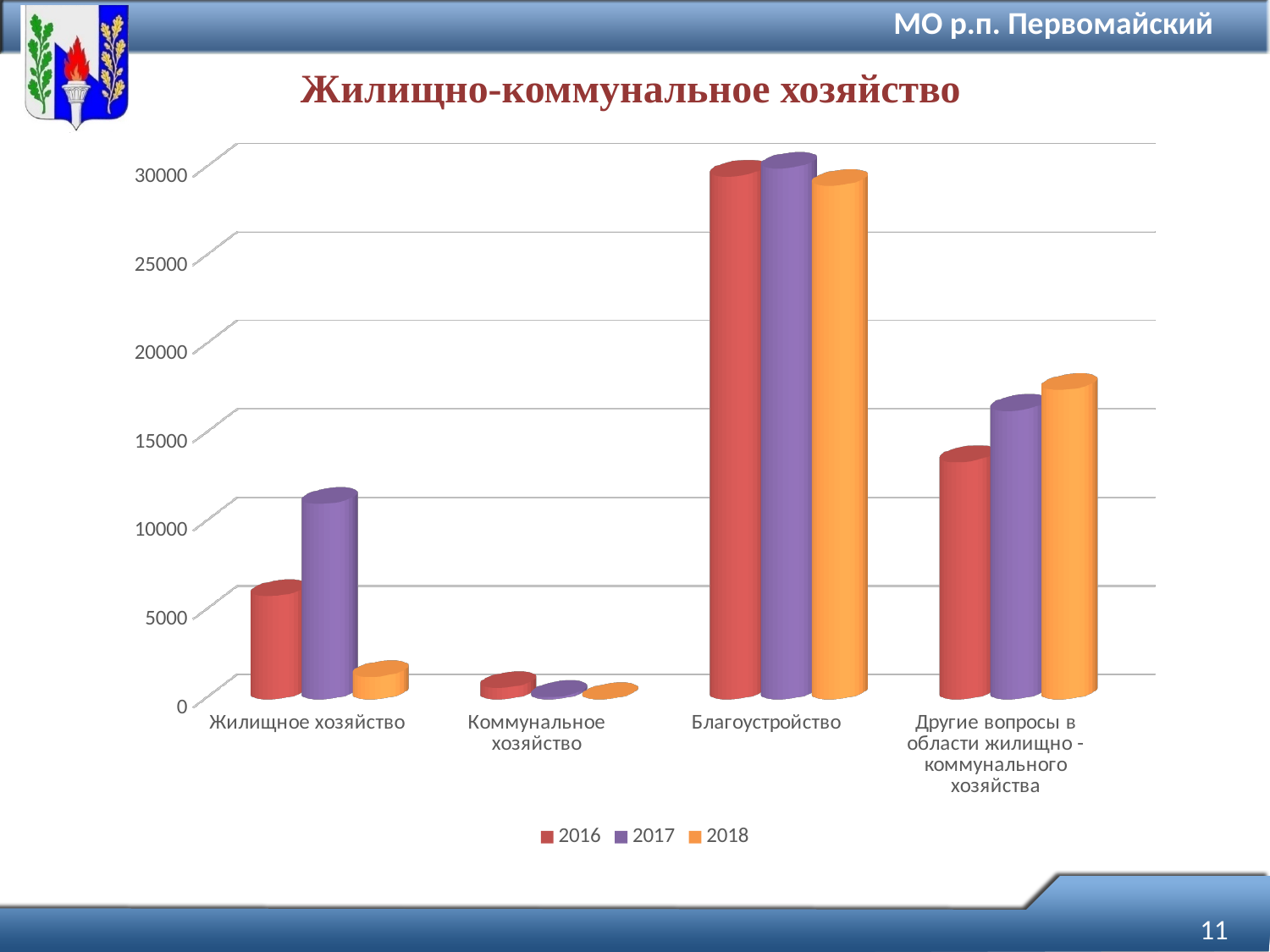
Is the value for Благоустройство in 2017 greater or less than 25000? greater What is the title of the chart? Жилищно-коммунальное хозяйство Is the value for Другие вопросы в области жилищно-коммунального хозяйства in 2016 greater or less than 15000? less Is the value for Жилищное хозяйство in 2018 greater or less than 5000? less What kind of chart is shown on the slide? bar chart How many series does the legend list? 3 For Жилищное хозяйство, which year has the larger value, 2016 or 2017? 2017 Which category has the lowest values in the chart? Коммунальное хозяйство Which category has the highest values in the chart? Благоустройство Do the values for Другие вопросы в области жилищно-коммунального хозяйства rise or fall from 2016 to 2018? rise How many categories are shown on the x axis of the chart? 4